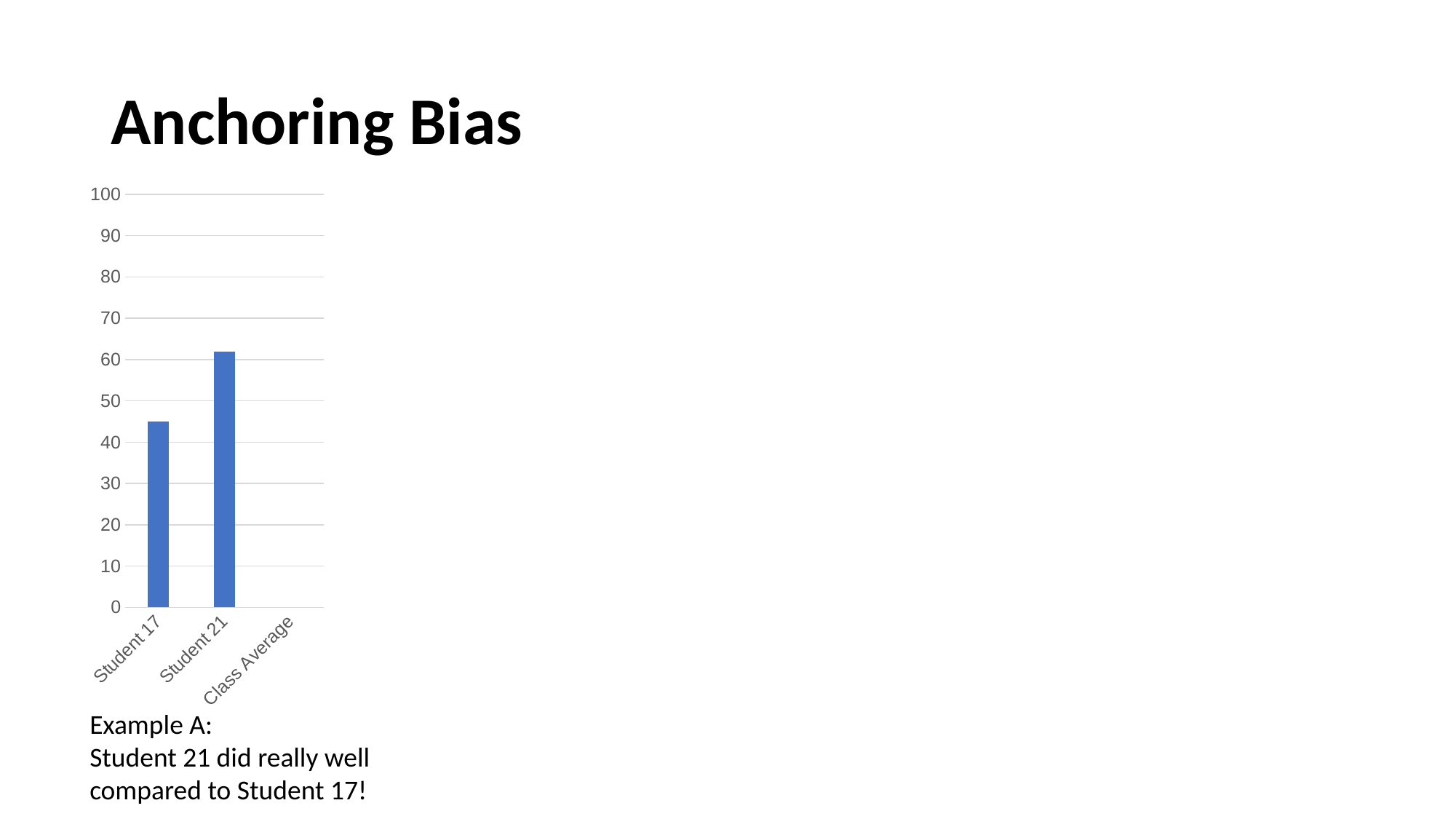
Is the value for Student 21 greater or less than 70? less Is the value for Student 21 greater or less than 50? greater What kind of chart is shown on the slide? bar chart What is the highest value shown on the y axis of the chart? 100 Which of Student 17 and Student 21 has the taller bar? Student 21 How many categories are labelled on the x axis of the chart? 3 Is the value for Student 17 greater or less than 50? less Which category on the x axis has no bar plotted? Class Average Which category has the highest bar in the chart? Student 21